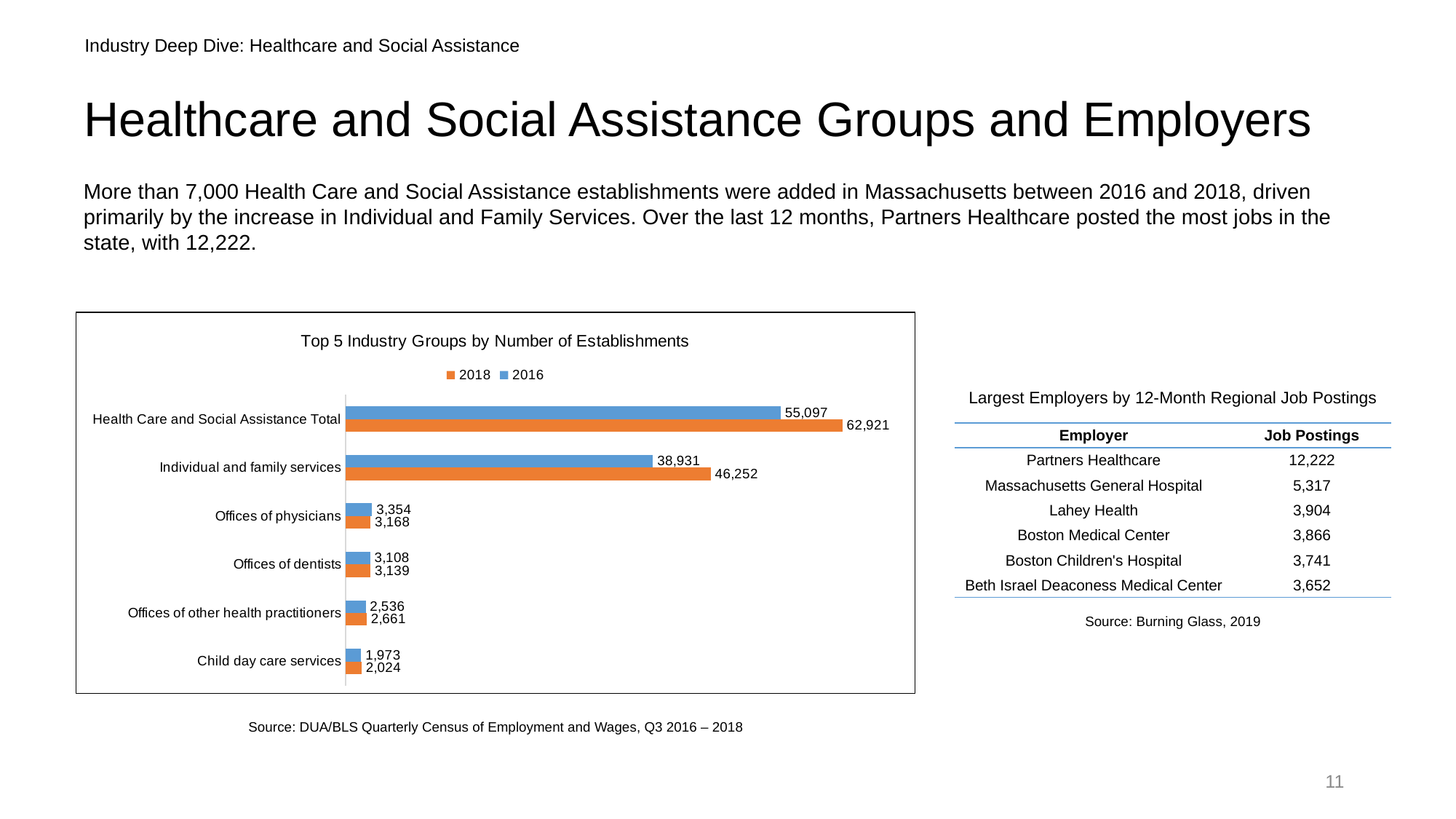
What is the 2016 value for Child day care services? 1,973 What is the 2018 value for Health Care and Social Assistance Total? 62,921 What is the difference between the 2018 and 2016 values for Health Care and Social Assistance Total? 7,824 What is the 2018 value for Offices of dentists? 3,139 What type of chart is shown on the slide? bar chart What is the 2016 value for Individual and family services? 38,931 How many categories are shown on the chart? 6 What is the difference between the 2018 and 2016 values for Individual and family services? 7,321 For Offices of physicians, which year has the larger value, 2016 or 2018? 2016 Excluding the Health Care and Social Assistance Total, which category has the highest 2016 value? Individual and family services How many series does the chart legend list? 2 Which category has the lowest 2018 value? Child day care services